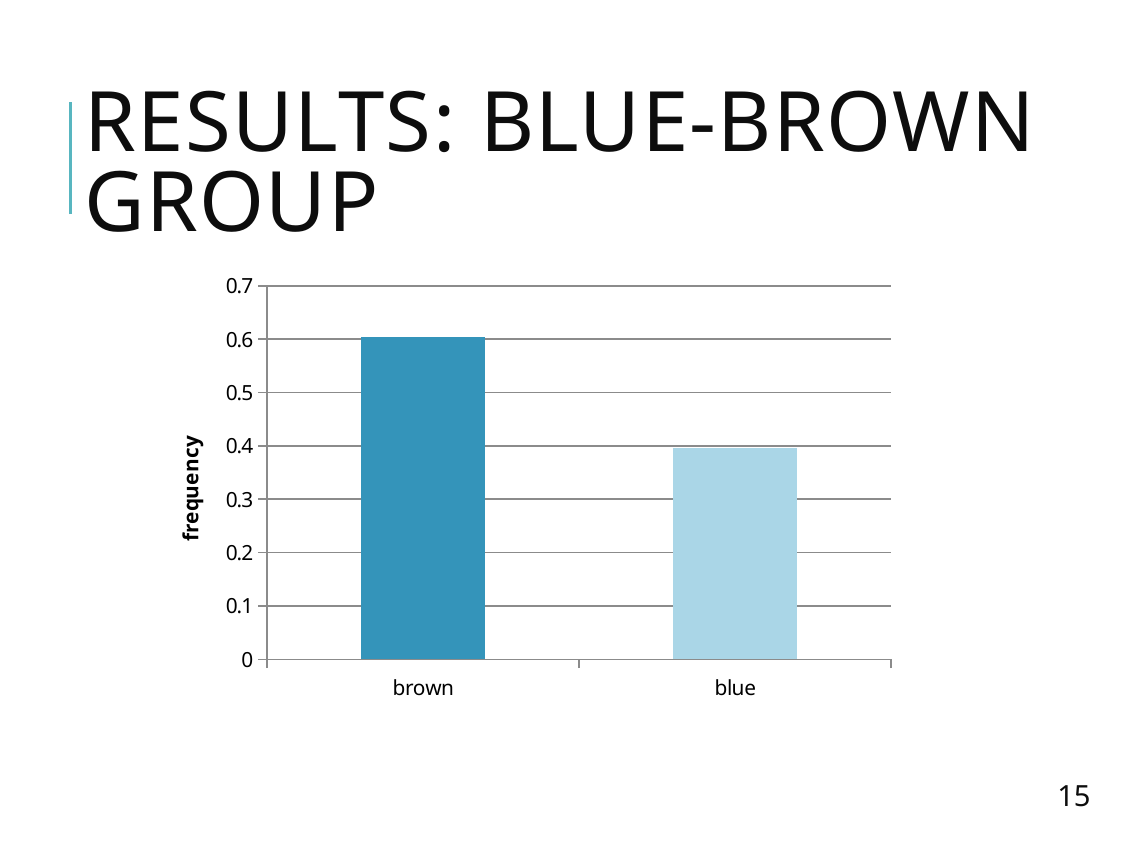
Is the frequency for blue greater or less than 0.5? less Which category has the highest frequency? brown Is the frequency for blue greater or less than 0.3? greater Do the bar values rise or fall from left to right along the x axis? fall How many categories are shown on the x axis of the chart? 2 Is the frequency for brown greater or less than 0.5? greater What is the label on the y axis of the chart? frequency What kind of chart is shown on the slide? bar chart What is the highest value shown on the y axis? 0.7 Which category has the lowest frequency? blue Which is larger, the frequency for brown or the frequency for blue? brown